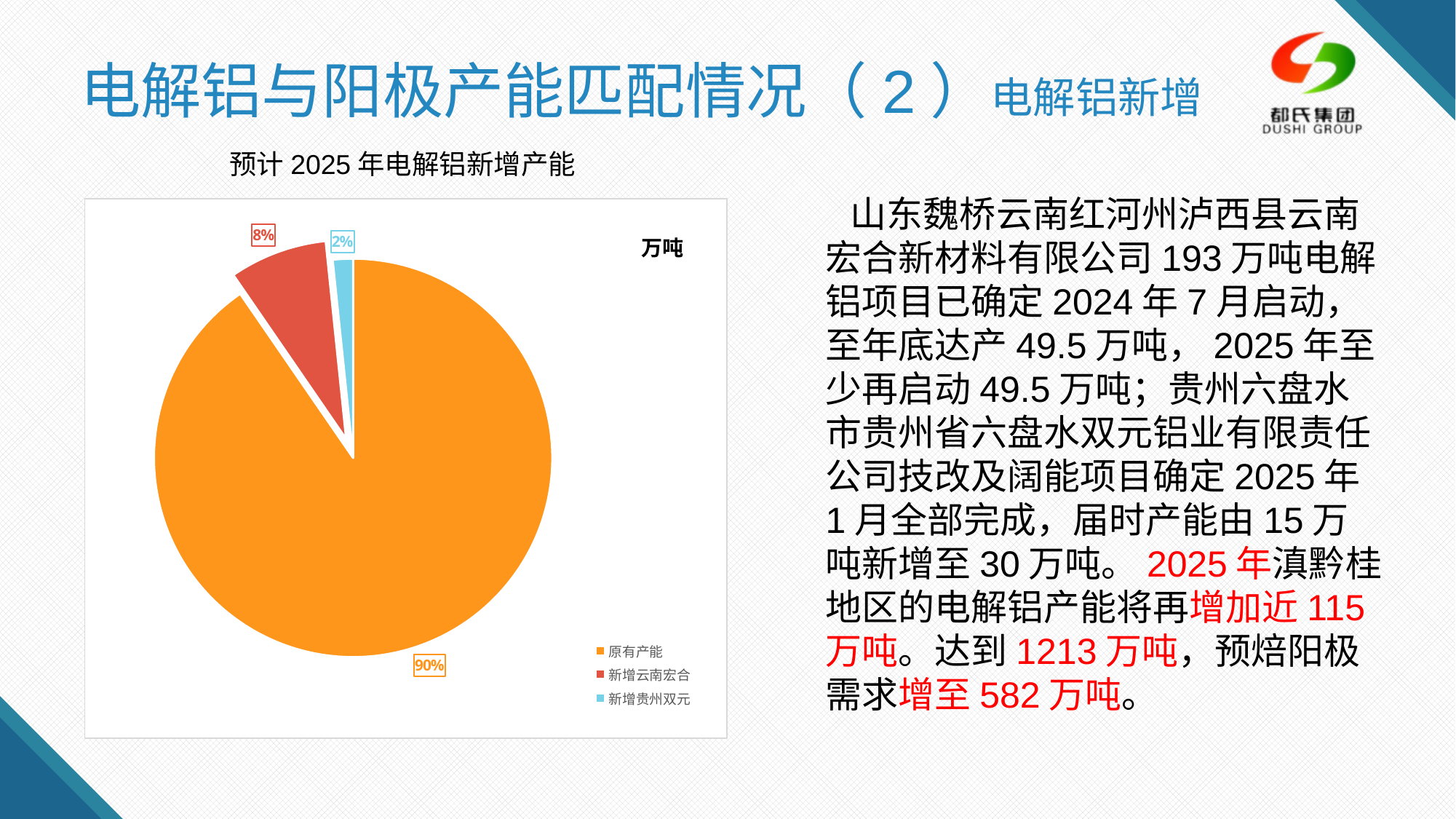
What is the difference in percentage points between the 新增云南宏合 slice and the 新增贵州双元 slice? 6% Which is larger, the share for 新增云南宏合 or the share for 新增贵州双元? 新增云南宏合 What share of the pie does 原有产能 represent? 90% What share of the pie does 新增云南宏合 represent? 8% What kind of chart is shown on the slide? pie chart What is the title shown above the pie chart? 预计 2025 年电解铝新增产能 What share of the pie does 新增贵州双元 represent? 2% Which slice of the pie chart is the largest? 原有产能 What is the combined share of the two 新增 slices (新增云南宏合 and 新增贵州双元)? 10% Which slice of the pie chart is the smallest? 新增贵州双元 How many entries does the legend of the pie chart list? 3 How many slices does the pie chart have? 3